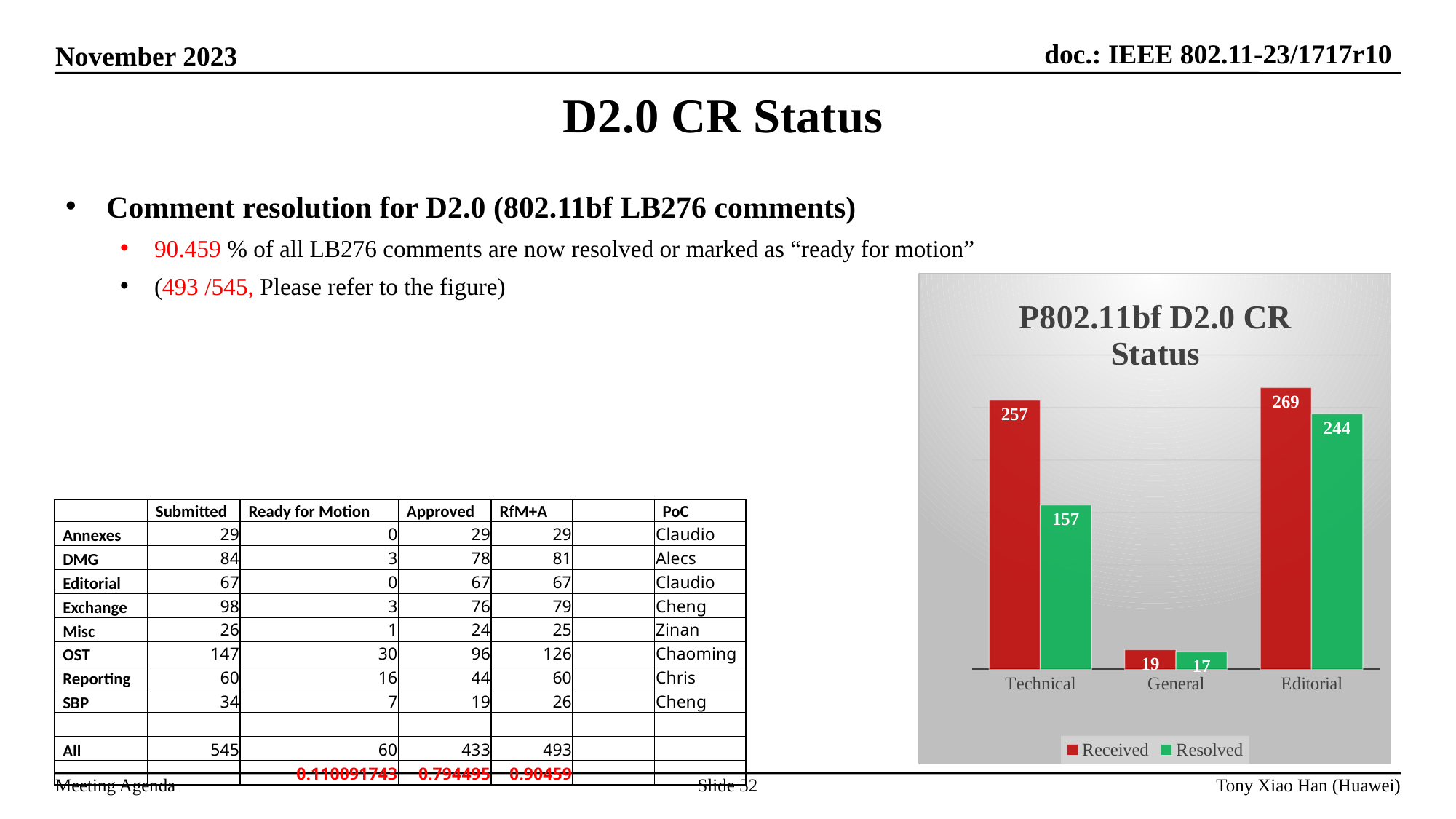
What is the Resolved value for General in the chart? 17 How many categories are shown on the x axis of the chart? 3 What is the Received value for Technical in the chart? 257 What is the difference between Received and Resolved for Technical? 100 What is the Resolved value for Editorial in the chart? 244 How many series does the chart legend list? 2 What is the difference between Received and Resolved for Editorial? 25 What is the title of the chart? P802.11bf D2.0 CR Status Which category has the lowest Resolved value in the chart? General Which category has the highest Received value in the chart? Editorial Which is larger: the Resolved value for Technical or the Resolved value for Editorial? Editorial What kind of chart is shown on the slide? Bar chart